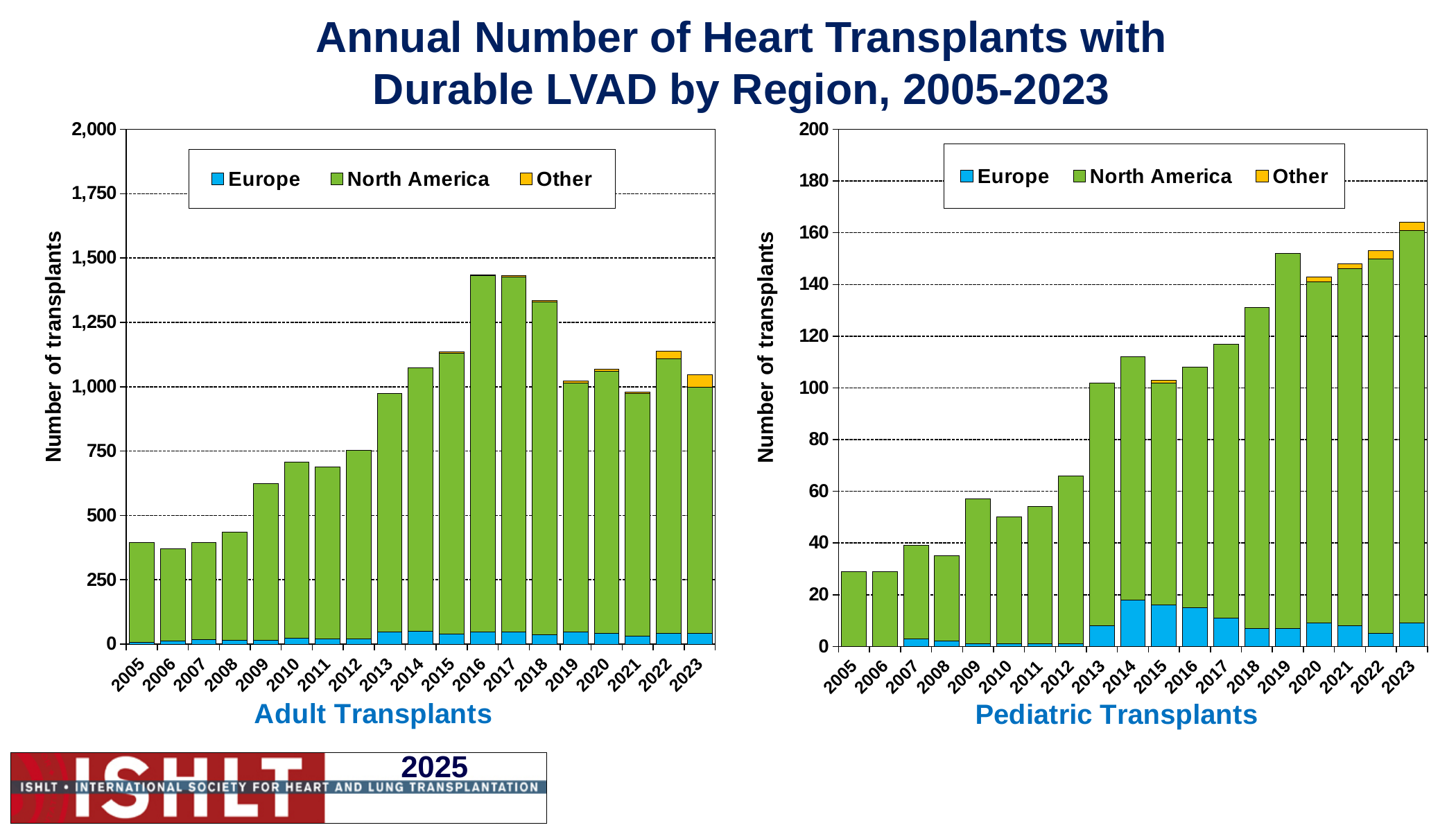
In the Pediatric Transplants chart, is the total for 2019 greater or less than 140? greater In the Adult Transplants chart, is the total for 2014 greater or less than 1,000? greater In the Adult Transplants chart, is the total for 2005 greater or less than 500? less How many years are shown on the x axis of the Adult Transplants chart? 19 What kind of chart is the Adult Transplants chart? Stacked bar chart In the Adult Transplants chart, which year has the larger total, 2016 or 2018? 2016 How many series does the legend of the Pediatric Transplants chart list? 3 In the Pediatric Transplants chart, which year has the larger total, 2019 or 2020? 2019 In the Pediatric Transplants chart, which year has the highest total number of transplants? 2023 In the Adult Transplants chart, do the totals generally rise or fall from 2005 to 2016? rise